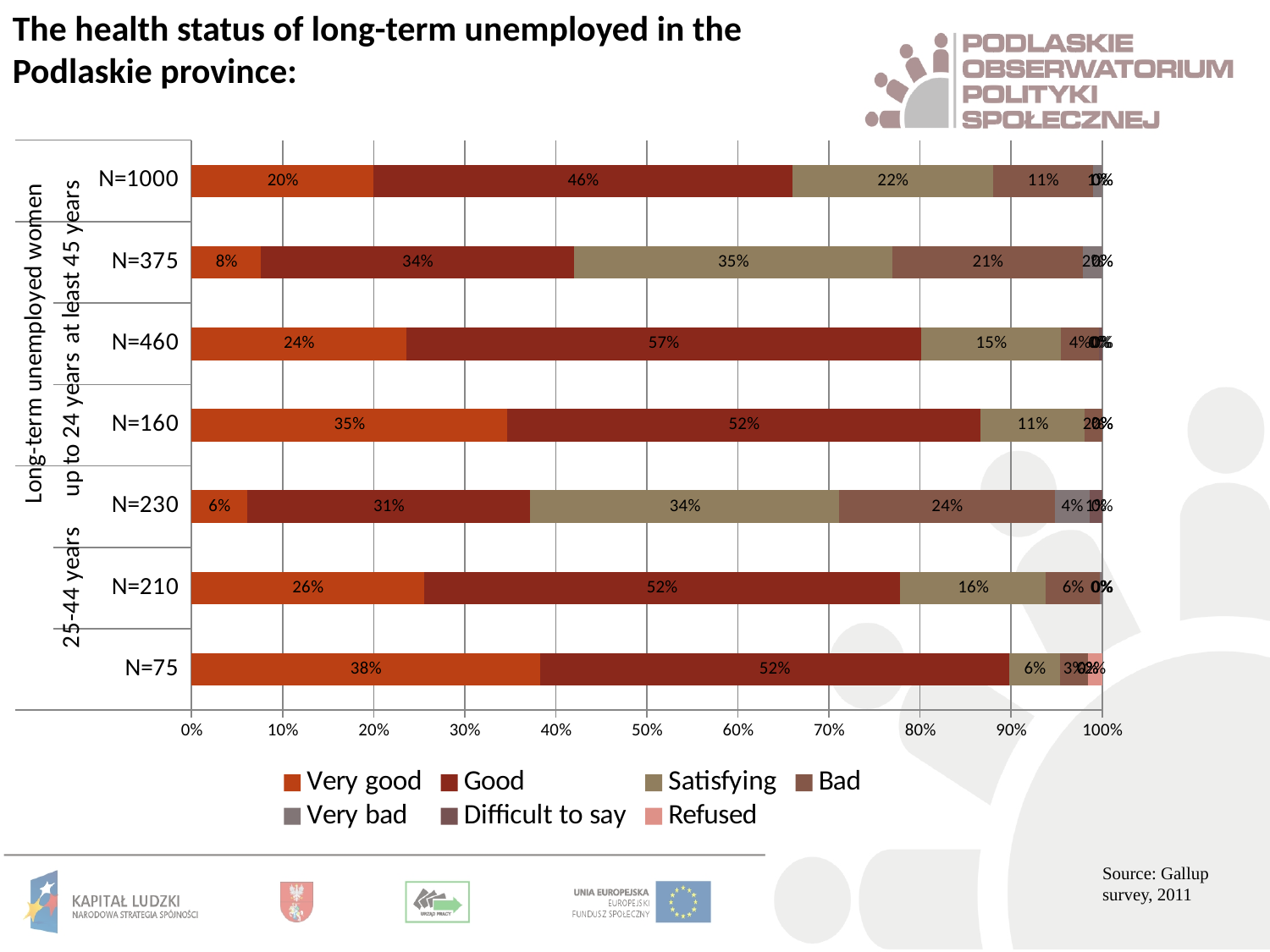
Which group has the highest 'Very good' value? N=75 What is the 'Good' value for the N=1000 group? 46% What is the 'Very good' value for the N=460 group? 24% How many series does the legend list? 7 Which group has the lowest 'Very good' value? N=230 What is the 'Satisfying' value for the N=375 group? 35% What kind of chart is shown on the slide? Stacked bar chart Which series is listed first in the legend? Very good How many categories (N groups) are plotted on the chart? 7 Which is larger, the 'Satisfying' value for N=1000 or for N=210? N=1000 What is the 'Bad' value for the N=230 group? 24% What is the difference between the 'Good' values for N=460 and N=375? 23%